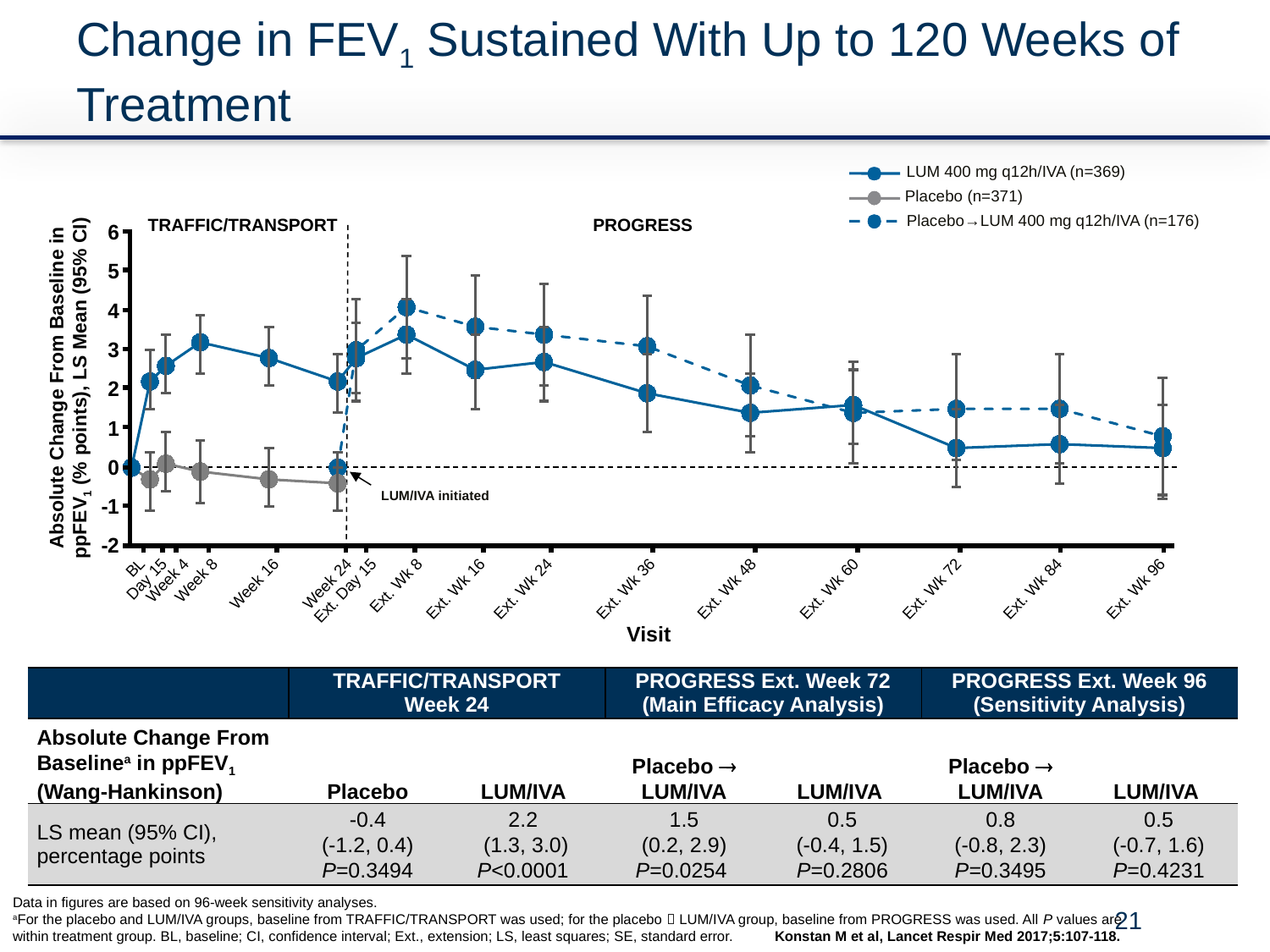
How many series does the chart legend list? 3 According to the legend, how many patients were in the Placebo group? n=371 Is the value for the Placebo→LUM 400 mg q12h/IVA group at Ext. Wk 36 greater or less than 2? greater How many visits are labelled along the x axis of the chart? 16 What is the LS mean absolute change from baseline in ppFEV1 for Placebo → LUM/IVA at PROGRESS Ext. Week 72, as shown in the table? 1.5 What is the difference between the LS mean values for LUM/IVA and Placebo at TRAFFIC/TRANSPORT Week 24 in the table? 2.6 At PROGRESS Ext. Week 72, which group has the larger LS mean change in the table: Placebo → LUM/IVA or LUM/IVA? Placebo → LUM/IVA What is the title of the x axis of the chart? Visit What is the LS mean absolute change from baseline in ppFEV1 for LUM/IVA at TRAFFIC/TRANSPORT Week 24, as shown in the table? 2.2 Is the value for the Placebo group at Week 16 greater or less than 0? less What kind of chart is shown on the slide? Line chart Is the value for the LUM 400 mg q12h/IVA group at Ext. Wk 72 greater or less than 1? less